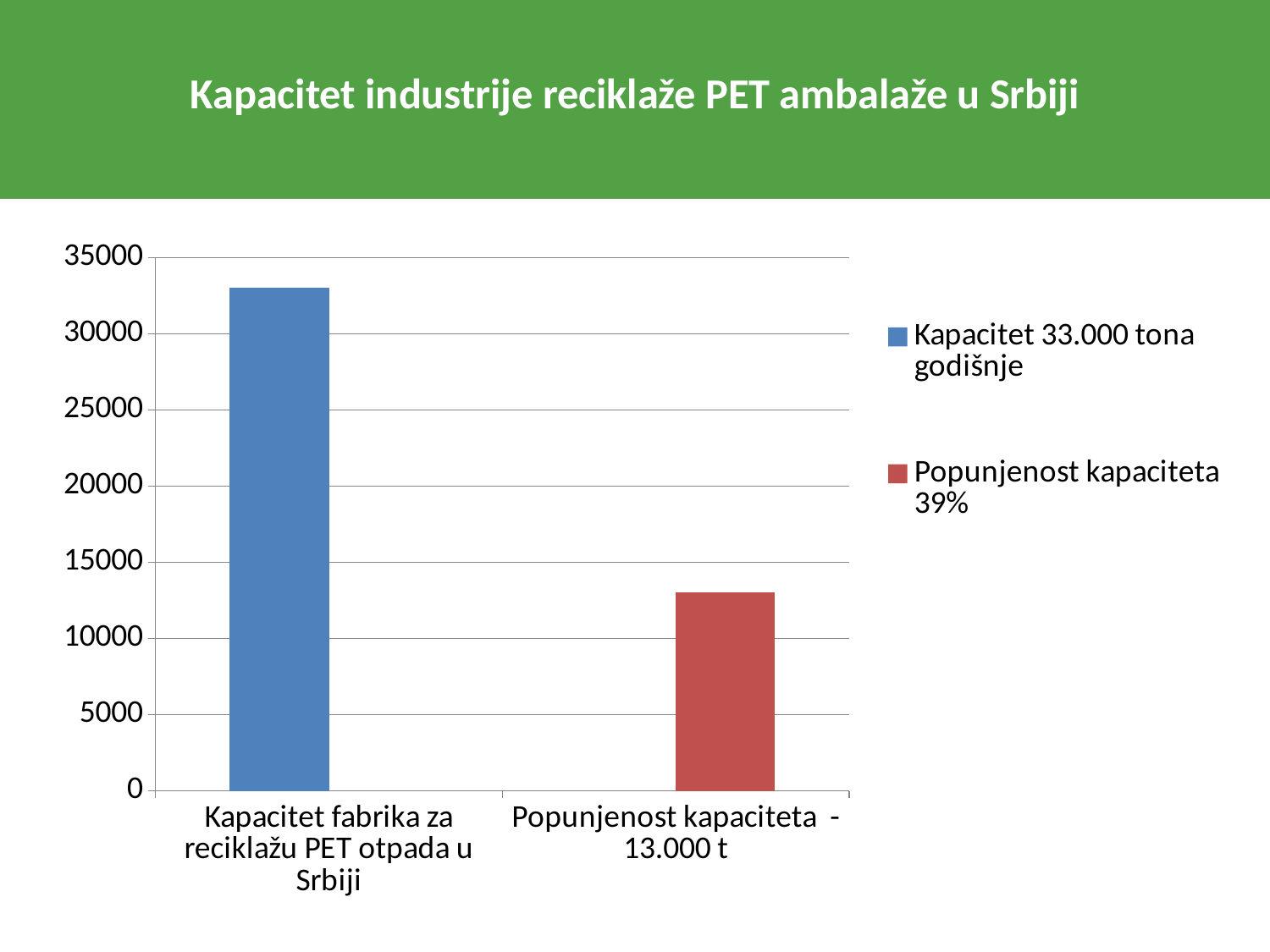
What value is given for 'Popunjenost kapaciteta' in the category label? 13.000 t What is the annual recycling capacity stated in the legend? 33.000 tona godišnje Which bar is the highest in the chart? Kapacitet fabrika za reciklažu PET otpada u Srbiji How many entries does the legend list? 2 Which is larger: the capacity of the PET recycling factories or the filled capacity? Kapacitet fabrika za reciklažu PET otpada u Srbiji What kind of chart is shown on the slide? bar chart What percentage of capacity is filled, according to the legend? 39% How many bars (categories) does the chart show? 2 What is the title of the chart on the slide? Kapacitet industrije reciklaže PET ambalaže u Srbiji Which bar is the lowest in the chart? Popunjenost kapaciteta - 13.000 t Is the value for 'Popunjenost kapaciteta' greater or less than 15000? less Is the value for 'Kapacitet fabrika za reciklažu PET otpada u Srbiji' greater or less than 30000? greater